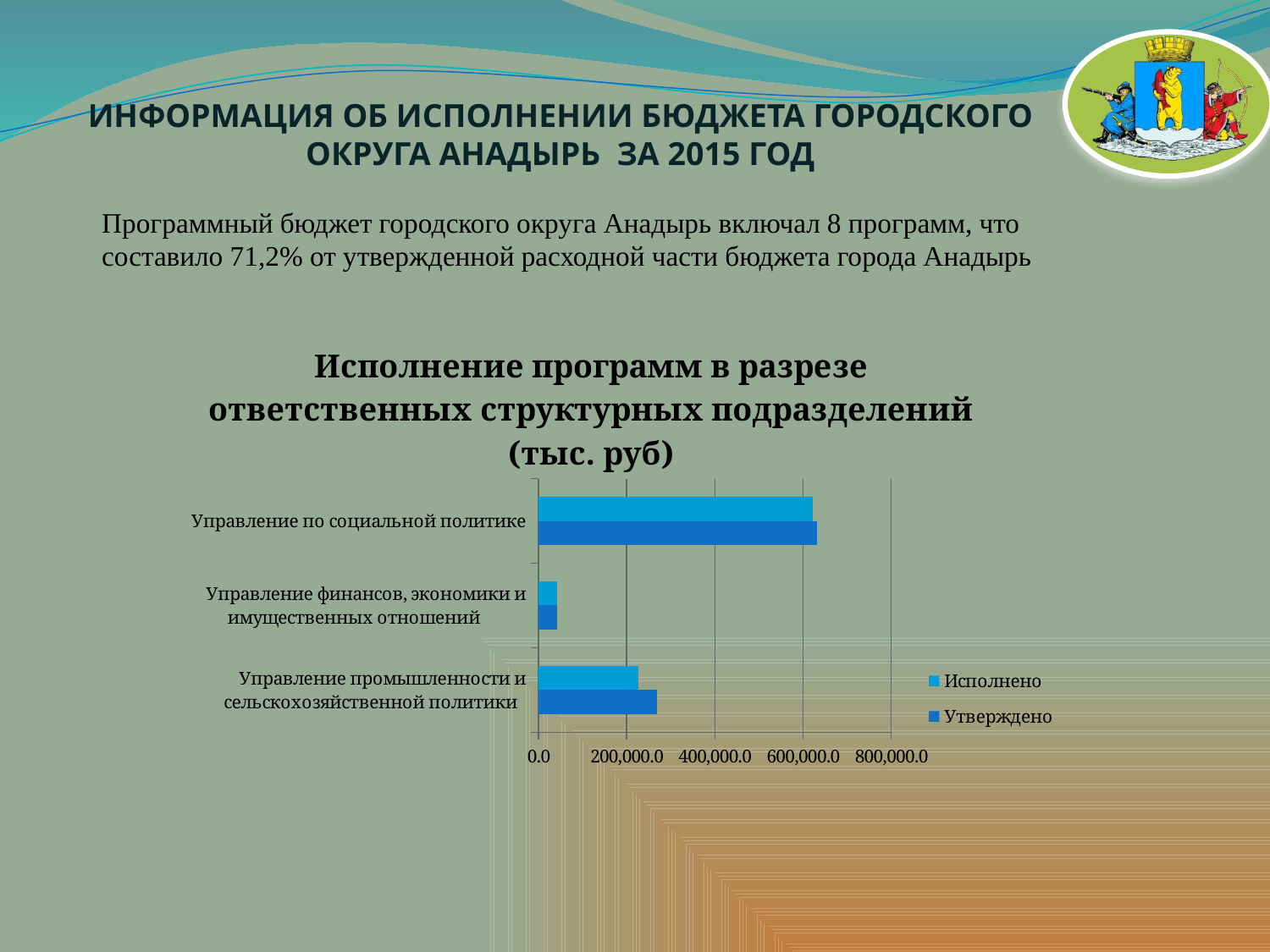
Is the Утверждено value for Управление промышленности и сельскохозяйственной политики greater or less than 400,000.0? less Which category has the highest value for Утверждено? Управление по социальной политике How many categories (structural units) are shown on the chart? 3 For Управление промышленности и сельскохозяйственной политики, which is larger: Исполнено or Утверждено? Утверждено What unit is given in the chart title? тыс. руб What kind of chart is shown on the slide? bar chart Is the Утверждено value for Управление финансов, экономики и имущественных отношений greater or less than 200,000.0? less How many series does the chart legend list? 2 Is the Исполнено value for Управление по социальной политике greater or less than 400,000.0? greater Which series is shown in the lighter blue colour in the legend? Исполнено Which category has the lowest value for Исполнено? Управление финансов, экономики и имущественных отношений